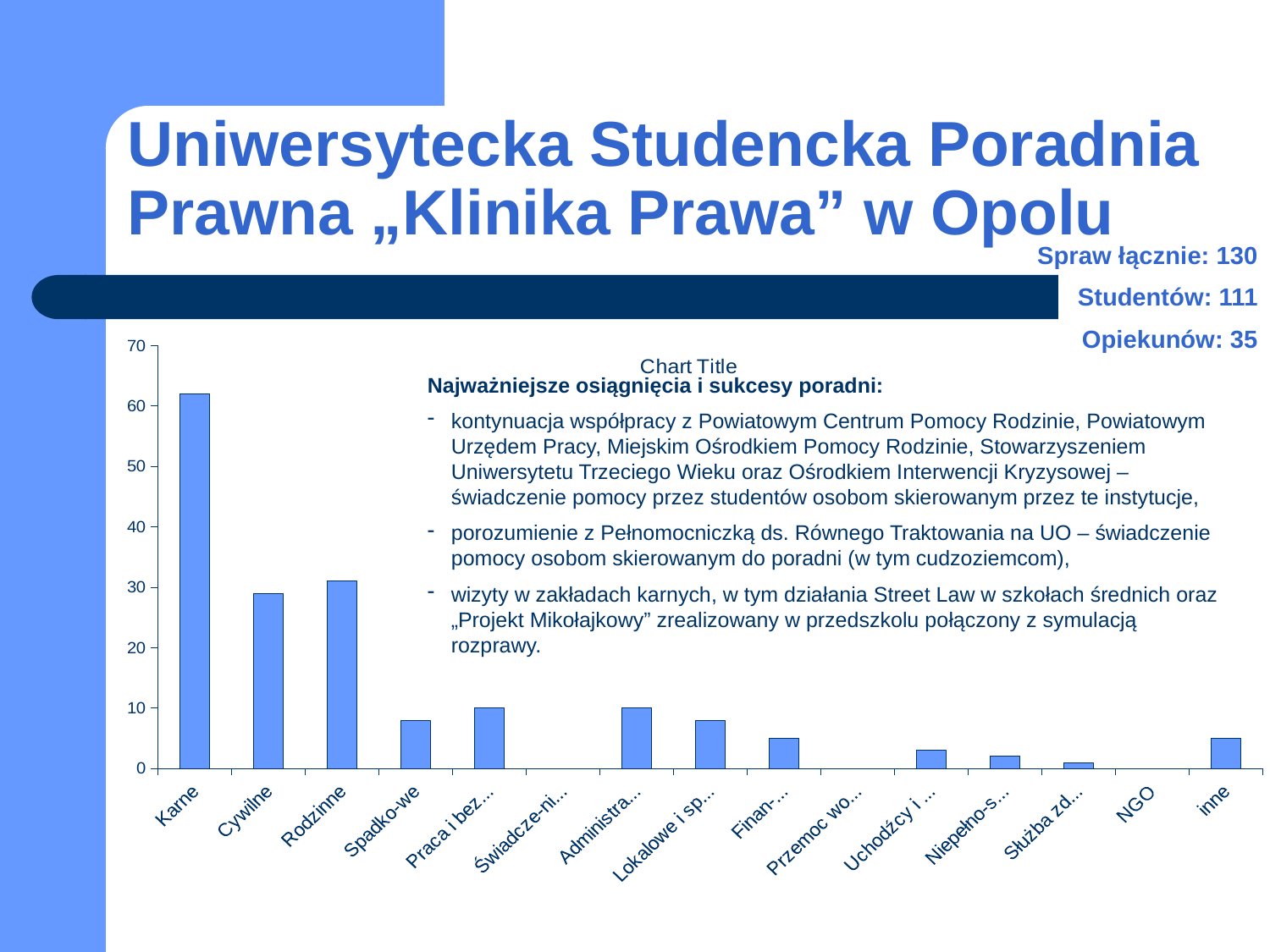
Is the value for Karne greater or less than 50? greater Which has a larger value, Karne or Cywilne? Karne Is the value for Rodzinne greater or less than 20? greater Is the value for Uchodźcy i ... greater or less than 10? less How many categories are shown on the x axis of the chart? 15 Which has a larger value, Spadko-we or Finan-...? Spadko-we Which category has the highest value in the chart? Karne What colour are the bars in the chart? blue What kind of chart is shown on the slide? bar chart What is the title shown on the chart? Chart Title